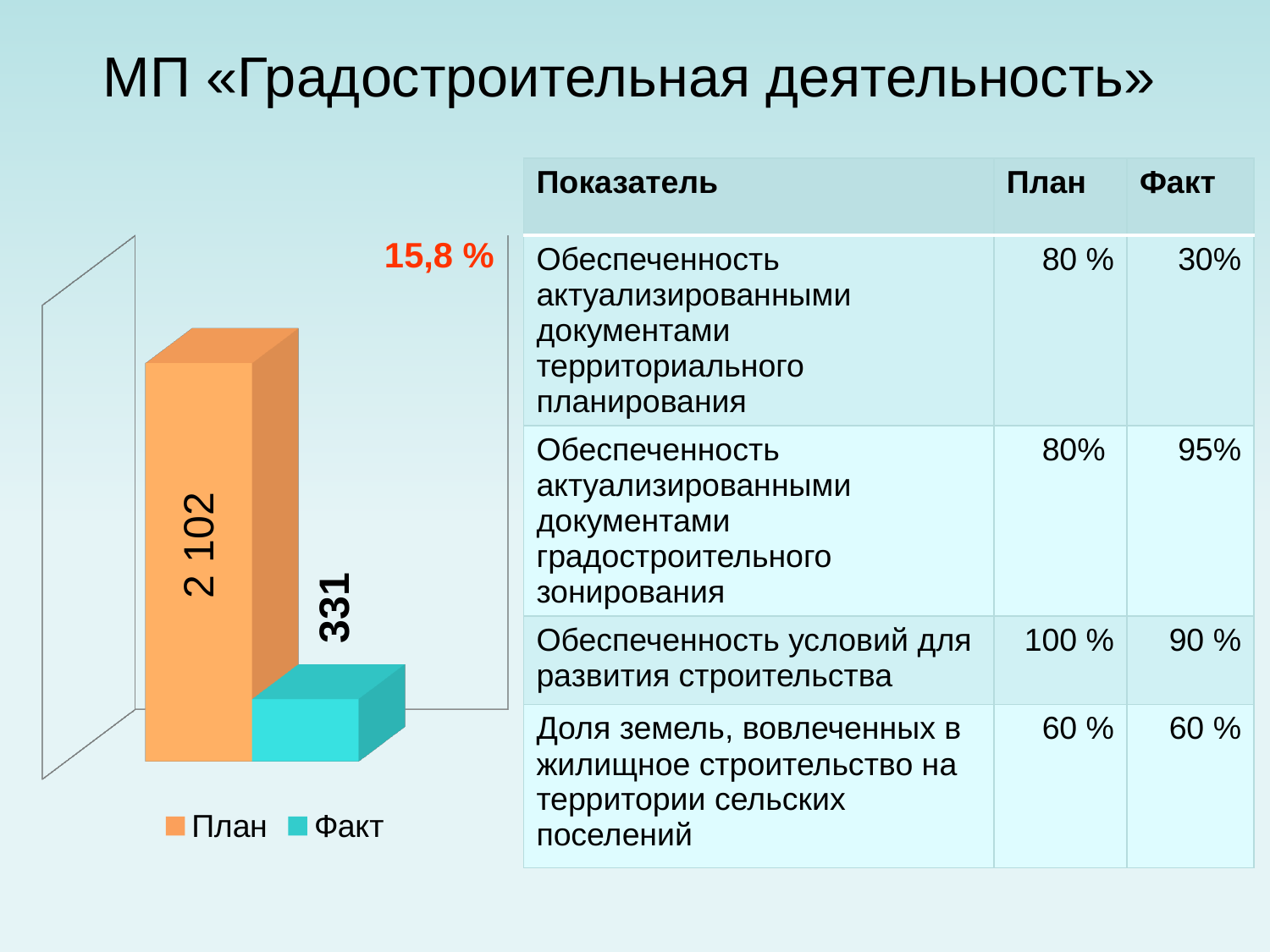
How many series does the chart legend list? 2 Which series has the highest value in the chart? План What percentage is printed in red above the chart? 15,8 % What kind of chart is shown on the slide? Bar chart How many bars are plotted in the chart? 2 What colour is the Факт bar in the chart? Turquoise Which series has the higher bar in the chart, План or Факт? План What is the value of the План bar in the chart? 2 102 Which series has the lowest value in the chart? Факт What is the difference between the План and Факт values in the chart? 1 771 What is the value of the Факт bar in the chart? 331